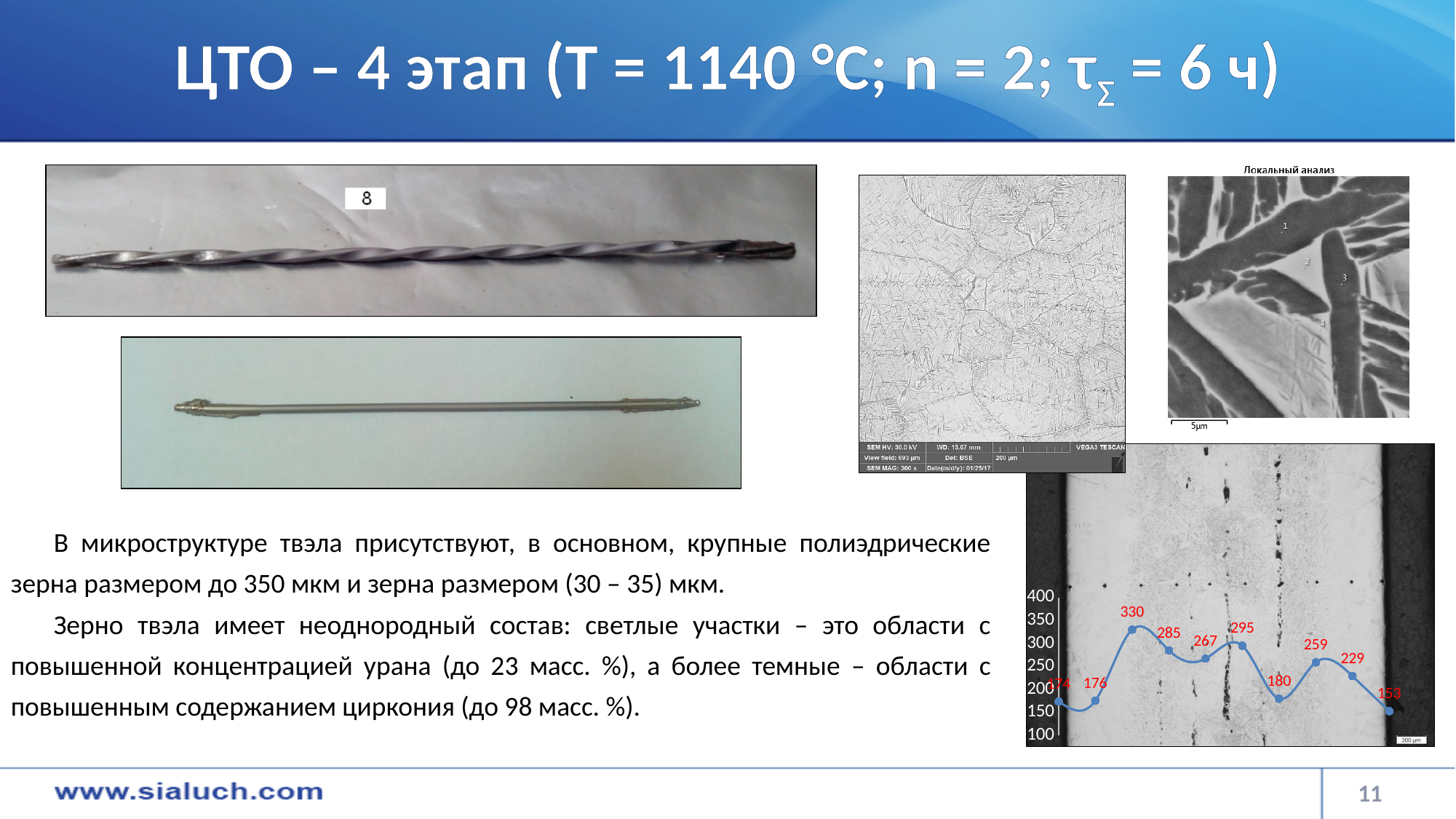
On the line chart at the bottom right of the slide, what is the difference between the points labelled 295 and 267? 28 What is the highest value labelled on the line chart at the bottom right of the slide? 330 How many data points are plotted on the line chart at the bottom right of the slide? 10 On the line chart at the bottom right of the slide, which is larger: the point labelled 259 or the point labelled 229? 259 On the line chart at the bottom right of the slide, what is the difference between the highest value (330) and the lowest value (153)? 177 What is the highest tick value shown on the vertical axis of the line chart at the bottom right of the slide? 400 What is the lowest tick value shown on the vertical axis of the line chart at the bottom right of the slide? 100 What is the value of the first (leftmost) point on the line chart at the bottom right of the slide? 174 What kind of chart is overlaid on the micrograph at the bottom right of the slide? line chart What is the lowest value labelled on the line chart at the bottom right of the slide? 153 On the line chart at the bottom right of the slide, is the point labelled 330 greater or less than 300 on the vertical axis? greater What is the value of the last (rightmost) point on the line chart at the bottom right of the slide? 153